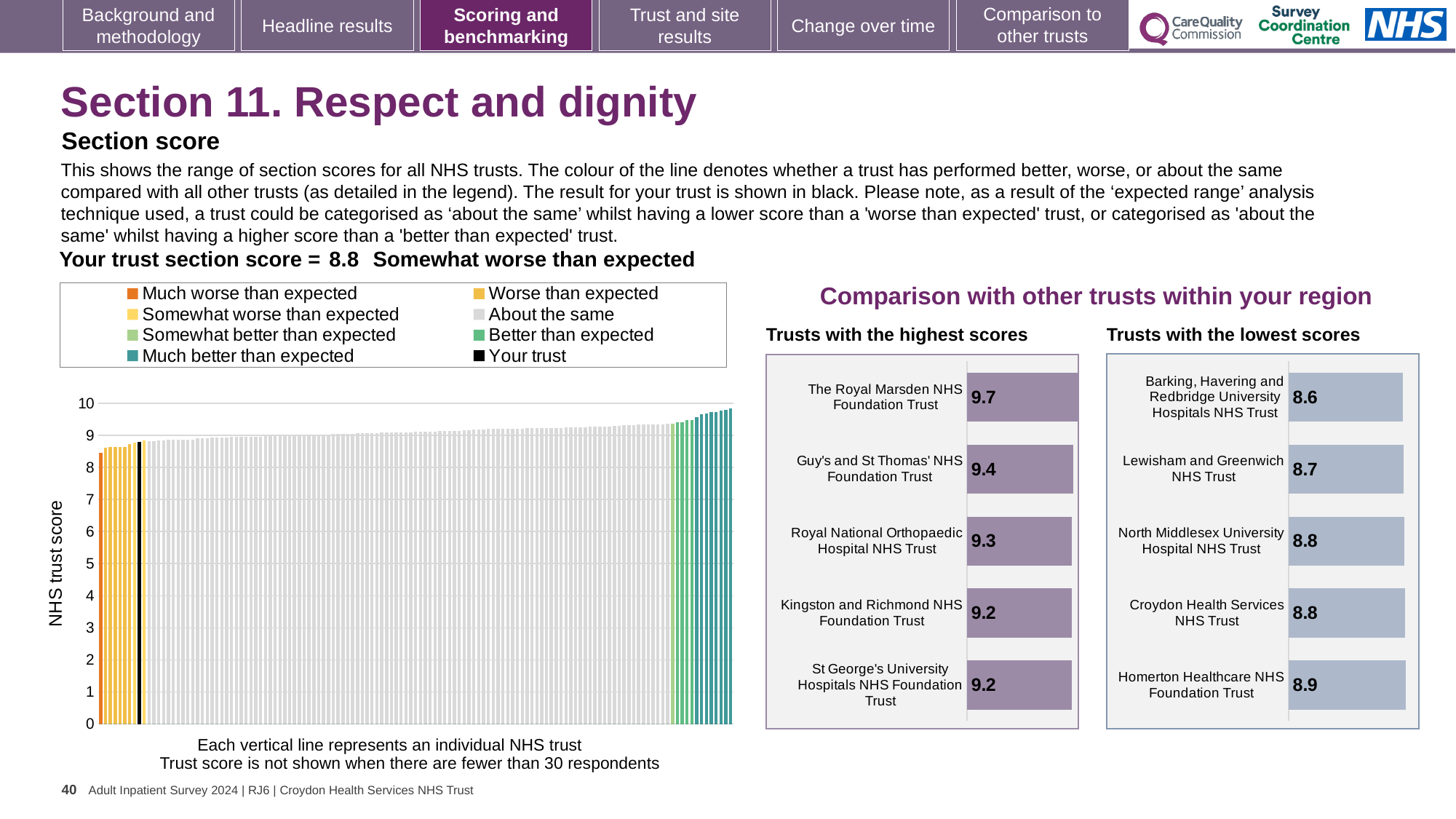
How many trusts are shown in the 'Trusts with the highest scores' chart? 5 In the 'Trusts with the highest scores' chart, which trust has the highest score? The Royal Marsden NHS Foundation Trust In the 'Trusts with the lowest scores' chart, which has the higher score: Lewisham and Greenwich NHS Trust or Homerton Healthcare NHS Foundation Trust? Homerton Healthcare NHS Foundation Trust In the 'Trusts with the highest scores' chart, what is the difference between the scores of The Royal Marsden NHS Foundation Trust and Guy's and St Thomas' NHS Foundation Trust? 0.3 What kind of chart is the large chart on the left showing NHS trust scores? bar chart In the 'Trusts with the lowest scores' chart, what is the score for Croydon Health Services NHS Trust? 8.8 In the 'Trusts with the lowest scores' chart, what is the score for Barking, Havering and Redbridge University Hospitals NHS Trust? 8.6 How many entries does the legend of the left-hand NHS trust score chart list? 8 In the 'Trusts with the highest scores' chart, what is the score for The Royal Marsden NHS Foundation Trust? 9.7 In the 'Trusts with the lowest scores' chart, which trust has the lowest score? Barking, Havering and Redbridge University Hospitals NHS Trust In the left-hand NHS trust score chart, is the value of the black 'Your trust' bar greater or less than 5? greater In the left-hand NHS trust score chart, do the bar heights rise or fall from left to right? rise